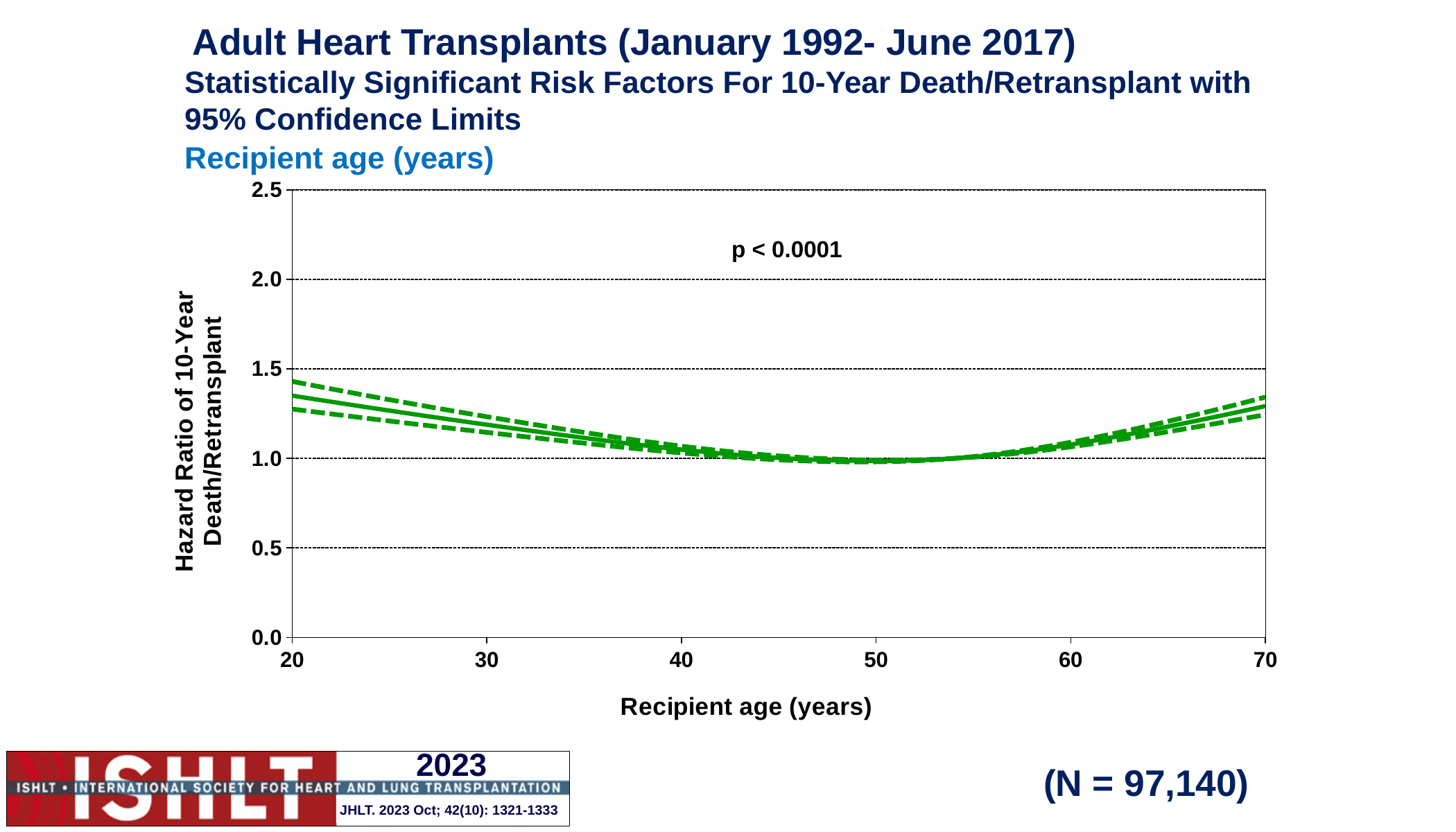
How many lines (solid and dashed) are plotted on the chart? 3 What kind of chart is shown on the slide? line chart Is the hazard ratio for a recipient age of 70 years greater or less than 1.5? less Which has the larger hazard ratio: a recipient age of 20 years or 50 years? 20 years Is the hazard ratio for a recipient age of 70 years greater or less than 1.0? greater Is the hazard ratio for a recipient age of 20 years greater or less than 1.5? less What is the label of the x axis? Recipient age (years) Does the hazard ratio rise or fall as recipient age increases from 50 to 70 years? rise What p-value is printed on the chart? p < 0.0001 Does the hazard ratio rise or fall as recipient age increases from 20 to 50 years? fall